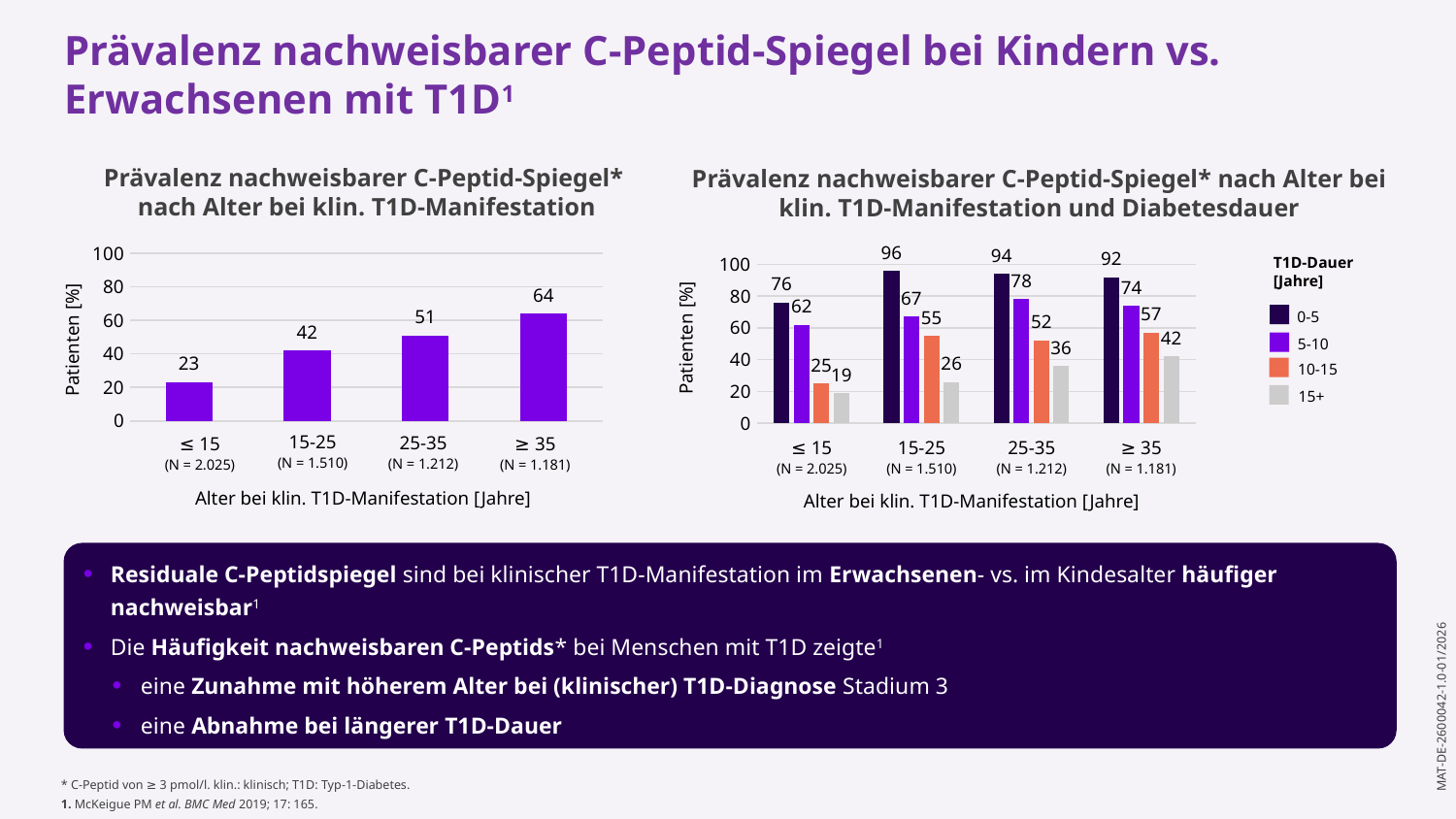
In the right chart, how many series does the legend list? 4 What type of chart is the left chart? bar chart In the right chart, which is larger for the 25-35 age group: the 5-10 or the 10-15 T1D duration value? 5-10 How many age groups are shown on the x axis of the right chart? 4 In the left chart (Prävalenz nachweisbarer C-Peptid-Spiegel nach Alter bei klin. T1D-Manifestation), what is the value for the age group 15-25? 42 In the left chart, which age group has the lowest value? ≤ 15 In the right chart (nach Alter bei klin. T1D-Manifestation und Diabetesdauer), what is the value for the 0-5 years T1D duration in the 15-25 age group? 96 In the left chart, do the values rise or fall as age at T1D manifestation increases? rise In the left chart, what is the difference between the values for ≥ 35 and ≤ 15? 41 In the right chart, what is the difference between the 0-5 and 15+ values for the ≥ 35 age group? 50 In the left chart, which age group has the highest value? ≥ 35 In the right chart, what is the value for the 15+ years T1D duration in the ≤ 15 age group? 19